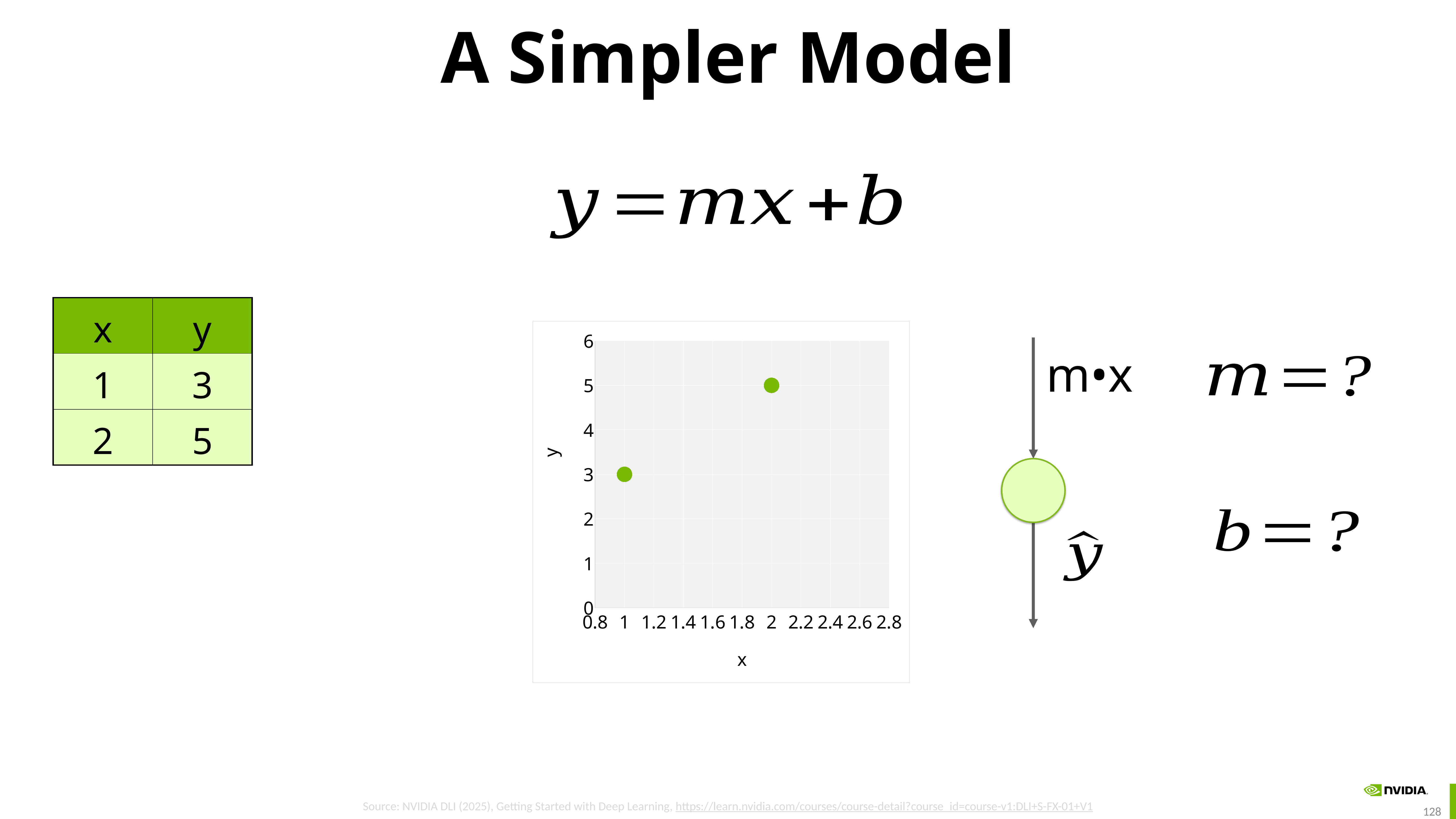
What is the y value of the point plotted at x = 2? 5 What is the difference between the y values at x = 2 and x = 1? 2 Is the y value of the point at x = 2 greater or less than 4? greater What is the y value of the point plotted at x = 1? 3 What is the label on the vertical axis of the chart? y At which x value does the chart show the highest y value? 2 Do the y values rise or fall as x increases along the x axis? rise What kind of chart is shown on the slide? scatter chart What is the highest value shown on the chart's y axis? 6 At which x value does the chart show the lowest y value? 1 How many data points are plotted on the chart? 2 Which point has the larger y value, the one at x = 1 or the one at x = 2? x = 2